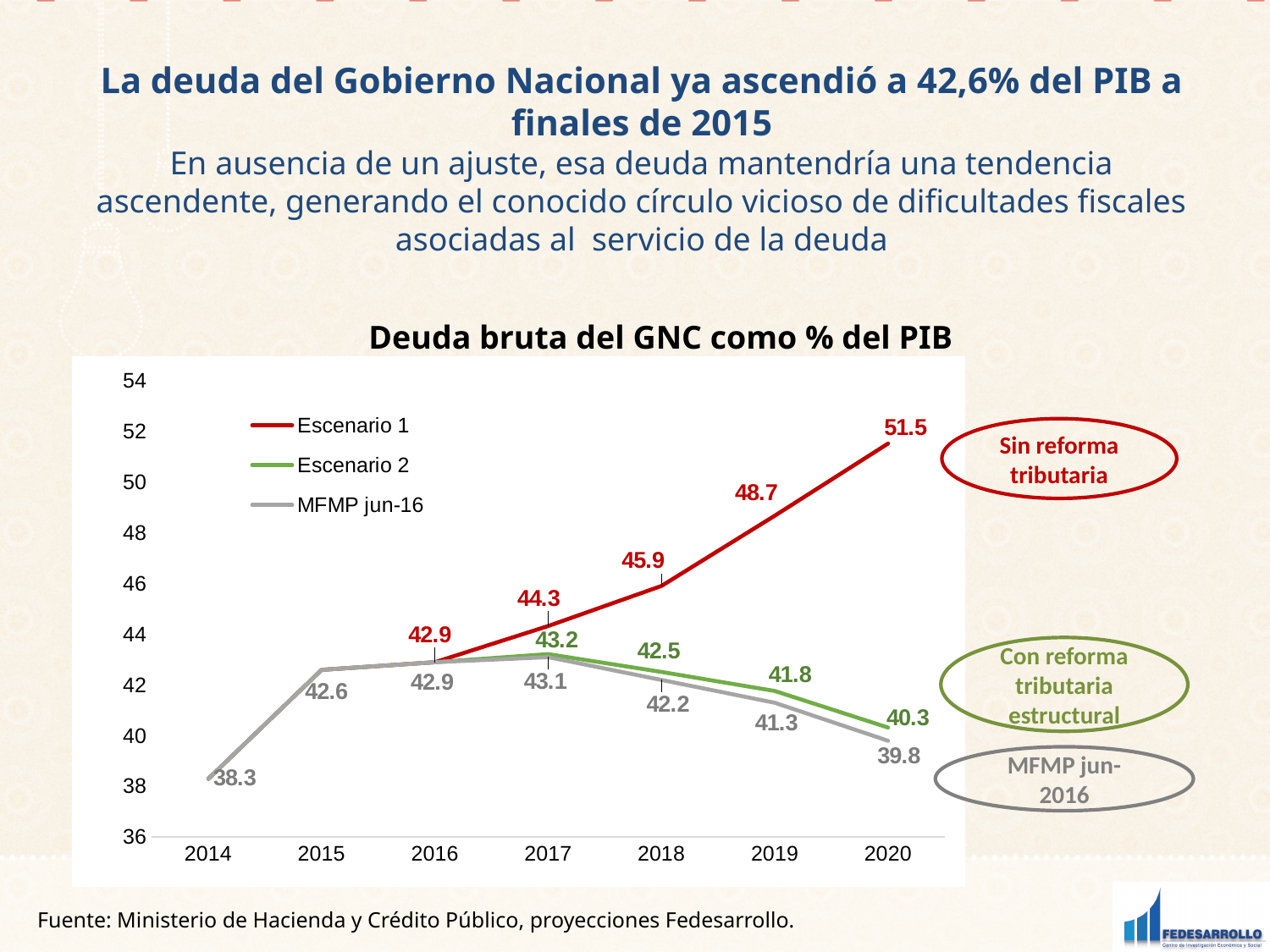
What is the title of the chart? Deuda bruta del GNC como % del PIB What is the value of Escenario 1 in 2020? 51.5 Does Escenario 1 rise or fall from 2016 to 2020? rise What is the difference between Escenario 1 and Escenario 2 in 2020? 11.2 What is the value of Escenario 2 in 2019? 41.8 How many series does the chart legend list? 3 In which year does Escenario 1 reach its highest value? 2020 What type of chart is shown on the slide? line chart What is the value of MFMP jun-16 in 2018? 42.2 How many years are shown on the x axis? 7 Which is larger in 2019, Escenario 2 or MFMP jun-16? Escenario 2 What is the value of Escenario 1 in 2017? 44.3